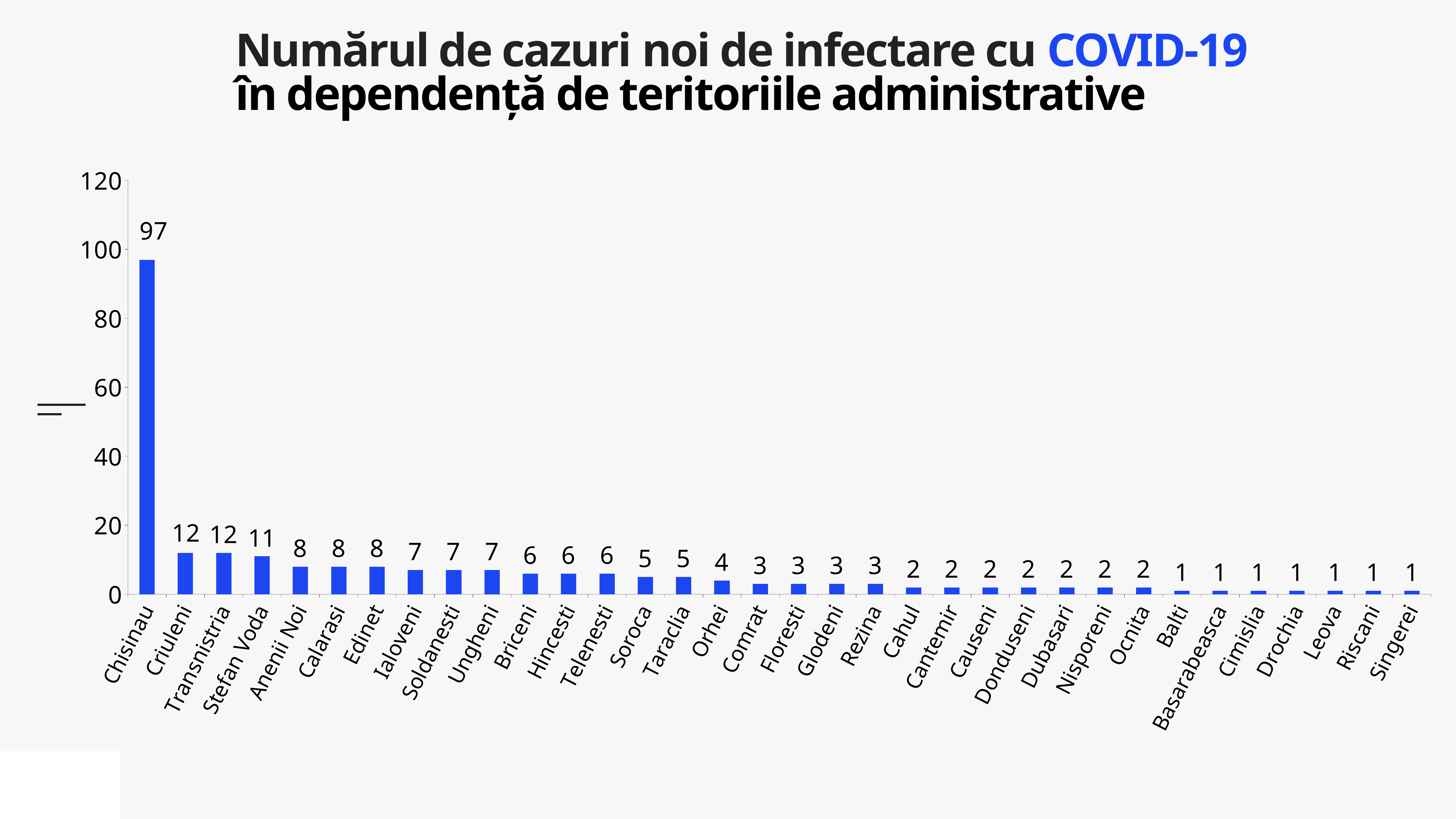
What is the difference between the values for Anenii Noi and Cahul? 6 How many territories are shown on the x axis? 34 What is the value for Chisinau? 97 Do the values rise or fall from left to right along the x axis? fall What is the value for Stefan Voda? 11 What is the value for Orhei? 4 Which is larger, the value for Briceni or the value for Comrat? Briceni What is the value for Soroca? 5 What kind of chart is shown on the slide? bar chart Is the value for Chisinau greater or less than 80? greater What is the difference between the values for Chisinau and Criuleni? 85 Which territory has the highest number of new cases? Chisinau